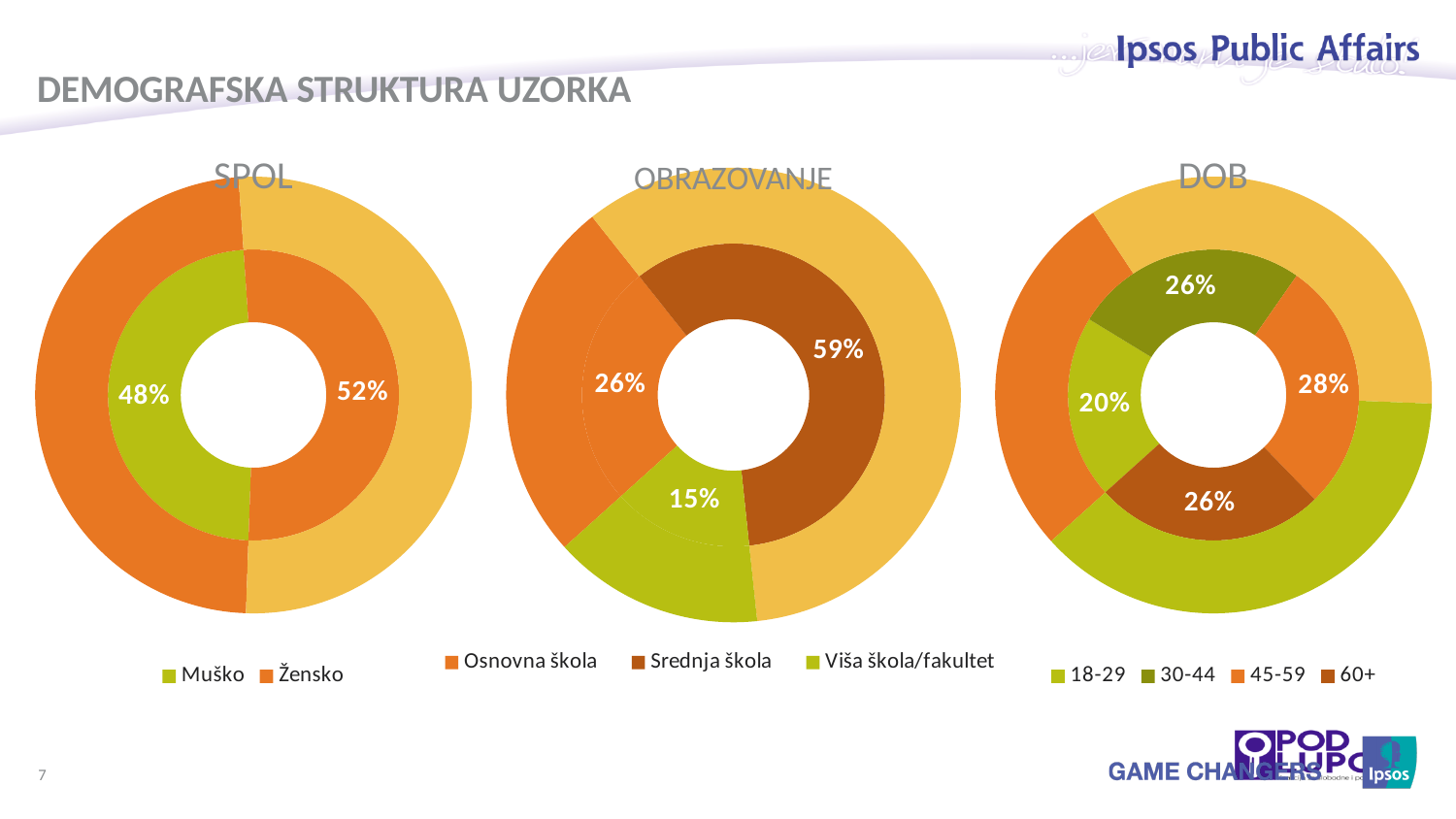
What type of chart is used for the SPOL chart? Doughnut chart In the DOB chart, what percentage is shown for the 45-59 group? 28% In the SPOL chart, what percentage is shown for Muško? 48% In the OBRAZOVANJE chart, what percentage is shown for Srednja škola? 59% In the OBRAZOVANJE chart, which category has the largest share? Srednja škola In the OBRAZOVANJE chart, what is the difference in percentage points between Srednja škola and Osnovna škola? 33 In the OBRAZOVANJE chart, which category has the smallest share? Viša škola/fakultet In the DOB chart, which age group has the smallest share? 18-29 How many categories does the legend of the DOB chart list? 4 In the DOB chart, what percentage is shown for the 18-29 group? 20% In the SPOL chart, what percentage is shown for Žensko? 52% In the OBRAZOVANJE chart, what percentage is shown for Viša škola/fakultet? 15%